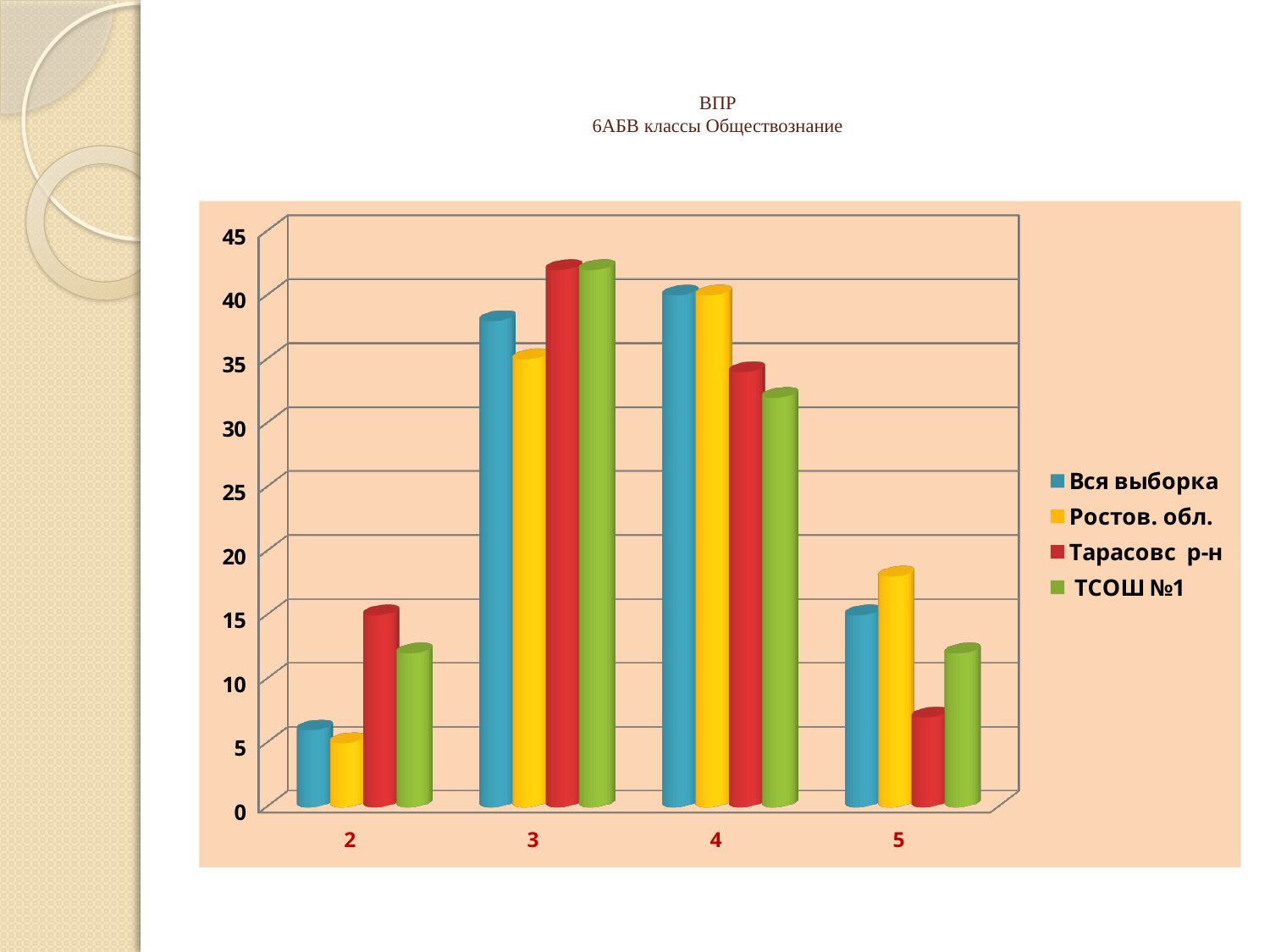
Which series has the highest value for category 2? Тарасовс р-н Is the value for Вся выборка in category 3 greater or less than 35? greater For category 3, which is larger: Вся выборка or Ростов. обл.? Вся выборка What is the title of the chart? ВПР 6АБВ классы Обществознание How many categories are shown on the x axis? 4 Is the value for Ростов. обл. in category 5 greater or less than 15? greater How many series does the legend list? 4 Is the value for Тарасовс р-н in category 5 greater or less than 10? less Which series has the highest value for category 5? Ростов. обл. What kind of chart is shown on the slide? bar chart Which series has the lowest value for category 5? Тарасовс р-н